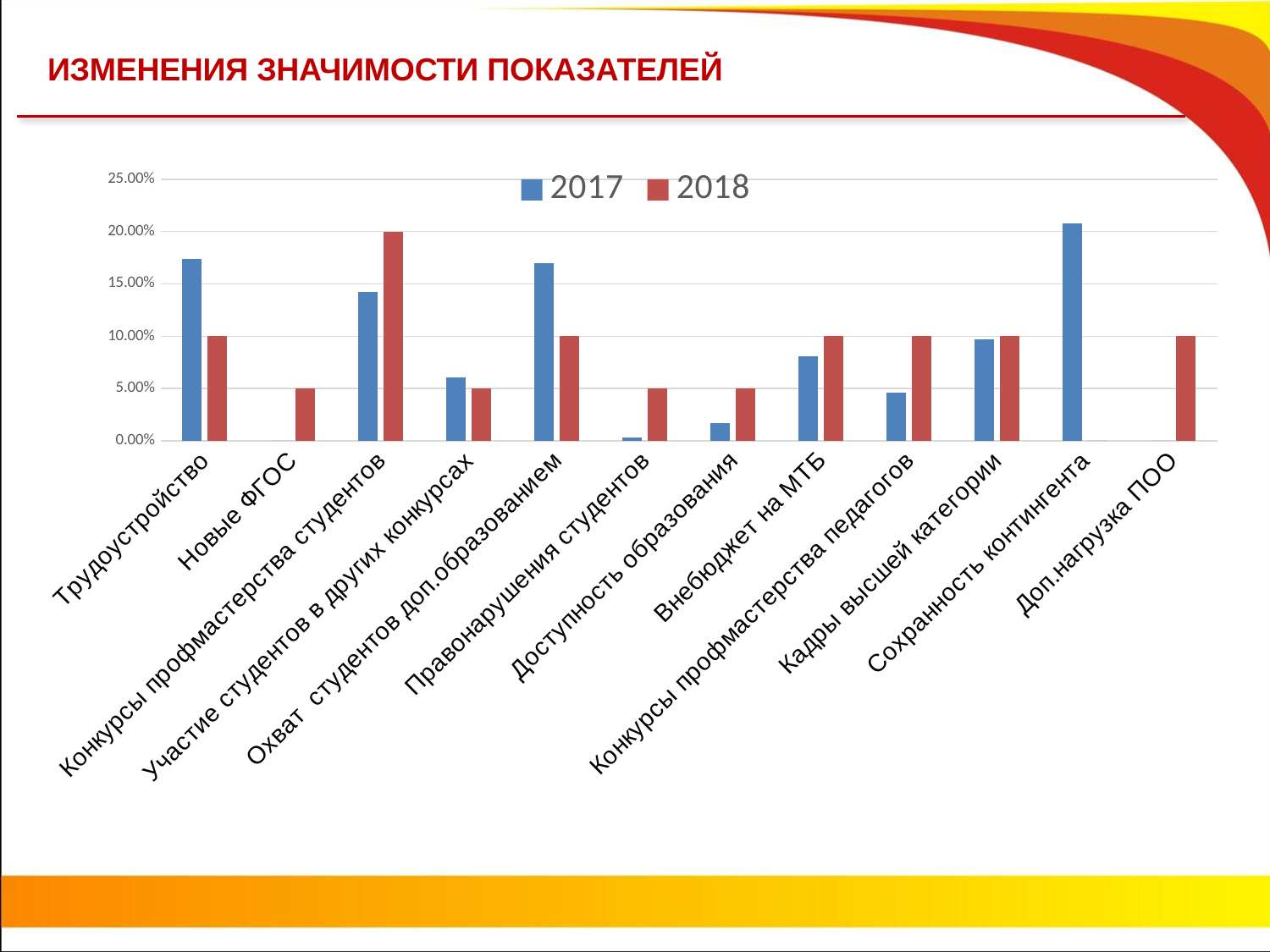
Which category has the highest 2018 value? Конкурсы профмастерства студентов What kind of chart is shown on the slide? bar chart How many series does the legend list? 2 For Трудоустройство, which is larger: the 2017 value or the 2018 value? 2017 Is the 2017 value for Трудоустройство greater or less than 15.00%? greater Which category has the highest 2017 value? Сохранность контингента What is the 2018 value for Новые ФГОС? 5.00% What is the 2018 value for Трудоустройство? 10.00% How many categories are shown on the x axis? 12 What is the 2018 value for Конкурсы профмастерства студентов? 20.00% Is the 2017 value for Внебюджет на МТБ greater or less than 10.00%? less What are the two series named in the legend? 2017 and 2018